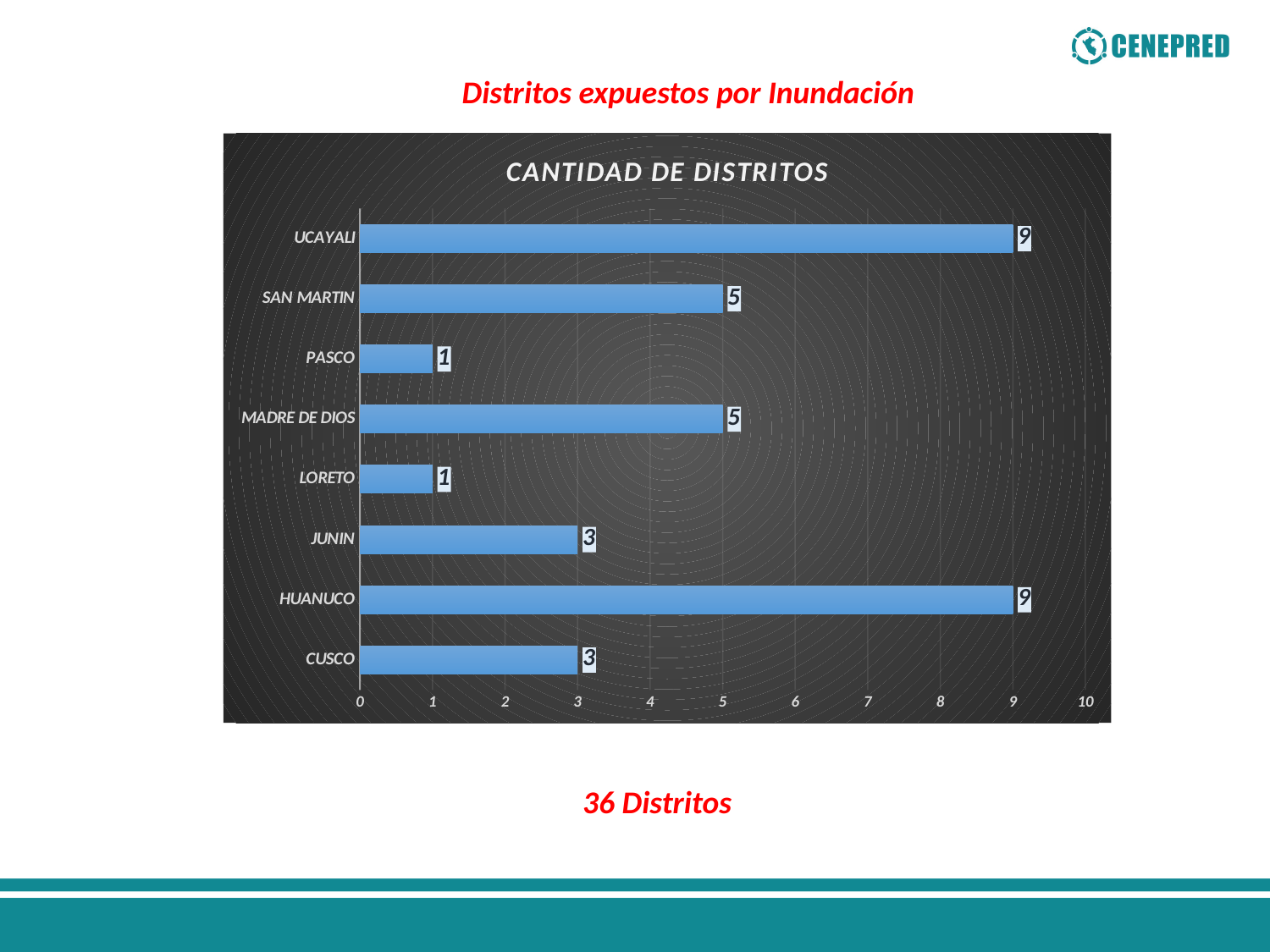
What is the difference between the values for HUANUCO and CUSCO? 6 What is the value for UCAYALI? 9 What kind of chart is shown on the slide? Bar chart Which categories have the lowest value? PASCO and LORETO How many categories are shown in the chart? 8 Which categories have the highest value? UCAYALI and HUANUCO Which is larger, the value for MADRE DE DIOS or the value for JUNIN? MADRE DE DIOS What is the value for LORETO? 1 What is the value for SAN MARTIN? 5 What is the title of the chart? CANTIDAD DE DISTRITOS Is the value for SAN MARTIN greater or less than 4? greater What is the value for JUNIN? 3